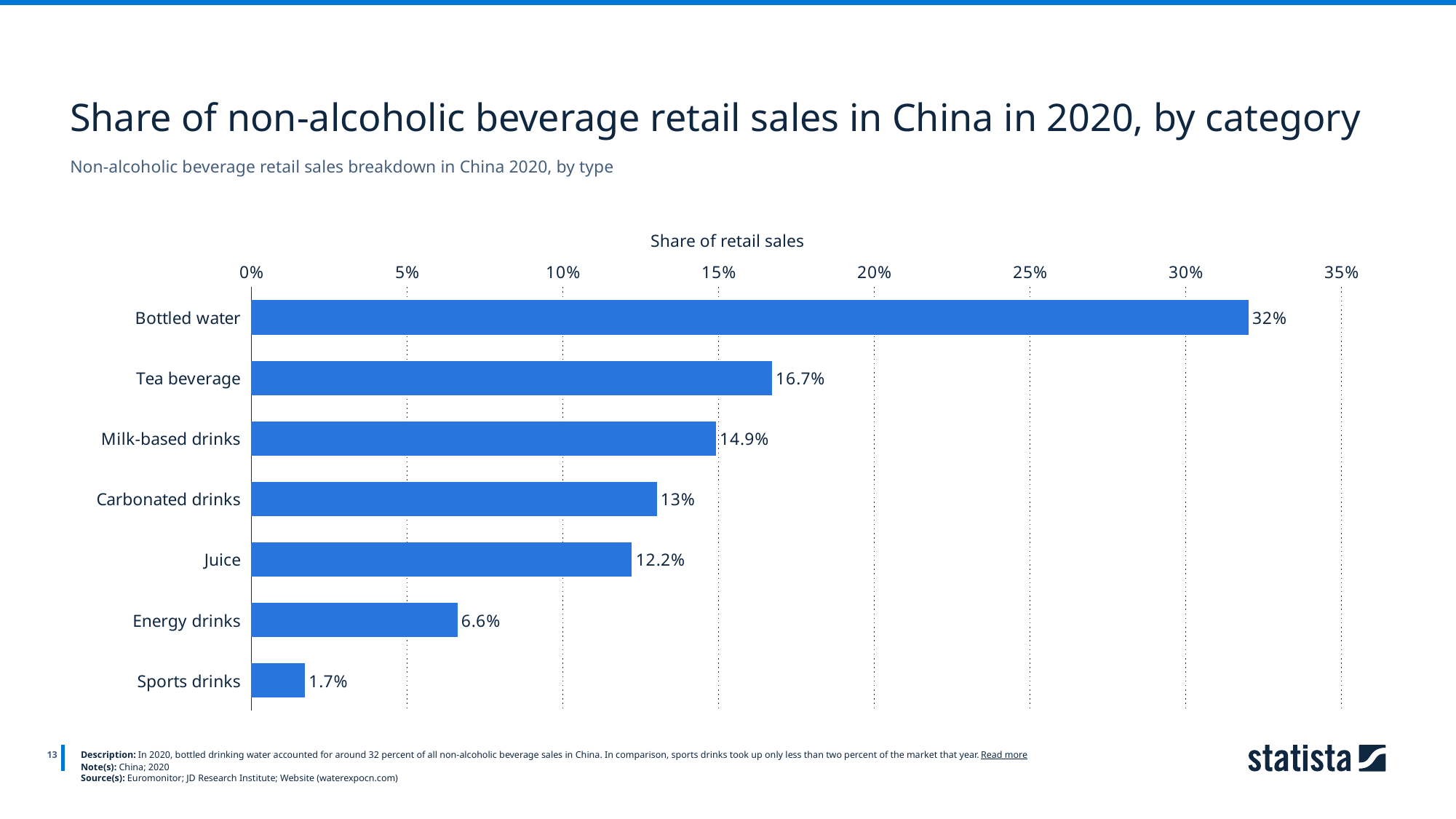
Which category has the lowest share of retail sales? Sports drinks What is the difference in share between Bottled water and Tea beverage? 15.3% What kind of chart is shown on the slide? Bar chart How many categories are shown in the chart? 7 What is the difference in share between Carbonated drinks and Juice? 0.8% Which category has the highest share of retail sales? Bottled water What is the share of retail sales for Energy drinks? 6.6% Which has a larger share of retail sales, Milk-based drinks or Carbonated drinks? Milk-based drinks What is the share of retail sales for Bottled water? 32% What is the share of retail sales for Tea beverage? 16.7% What is the title of the chart's value axis? Share of retail sales Is the value for Juice greater or less than 10%? greater